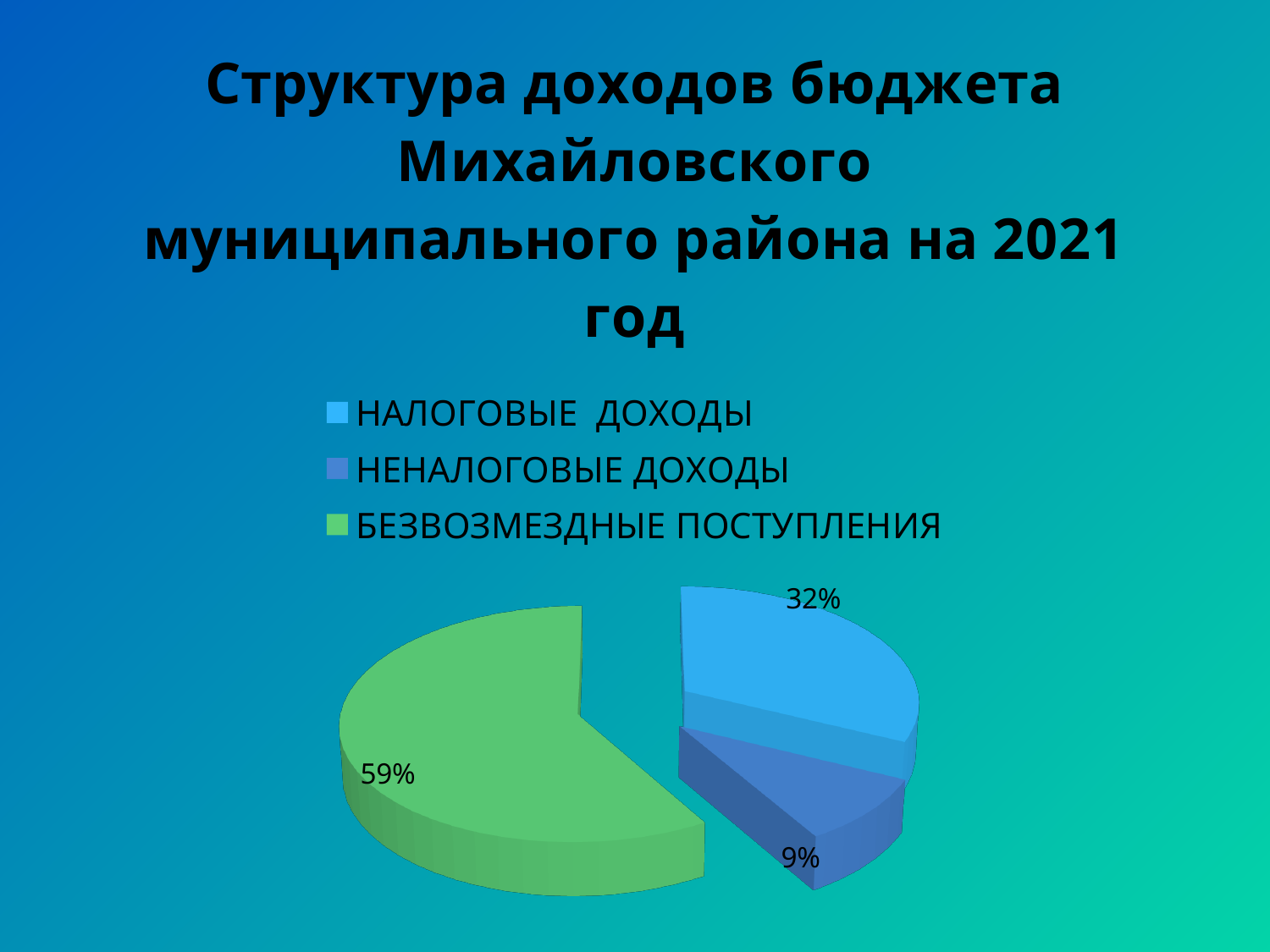
What kind of chart is shown on the slide? Pie chart What is the difference in percentage points between НАЛОГОВЫЕ ДОХОДЫ and НЕНАЛОГОВЫЕ ДОХОДЫ? 23 What share of the pie does НЕНАЛОГОВЫЕ ДОХОДЫ represent? 9% What is the title of the chart on the slide? Структура доходов бюджета Михайловского муниципального района на 2021 год What colour is the slice for БЕЗВОЗМЕЗДНЫЕ ПОСТУПЛЕНИЯ? Green What share of the pie does БЕЗВОЗМЕЗДНЫЕ ПОСТУПЛЕНИЯ represent? 59% How many categories are shown in the pie chart? 3 What is the difference in percentage points between БЕЗВОЗМЕЗДНЫЕ ПОСТУПЛЕНИЯ and НАЛОГОВЫЕ ДОХОДЫ? 27 Which is larger, the share for НАЛОГОВЫЕ ДОХОДЫ or the share for НЕНАЛОГОВЫЕ ДОХОДЫ? НАЛОГОВЫЕ ДОХОДЫ Which category has the smallest slice of the pie? НЕНАЛОГОВЫЕ ДОХОДЫ What share of the pie does НАЛОГОВЫЕ ДОХОДЫ represent? 32% Which category has the largest slice of the pie? БЕЗВОЗМЕЗДНЫЕ ПОСТУПЛЕНИЯ